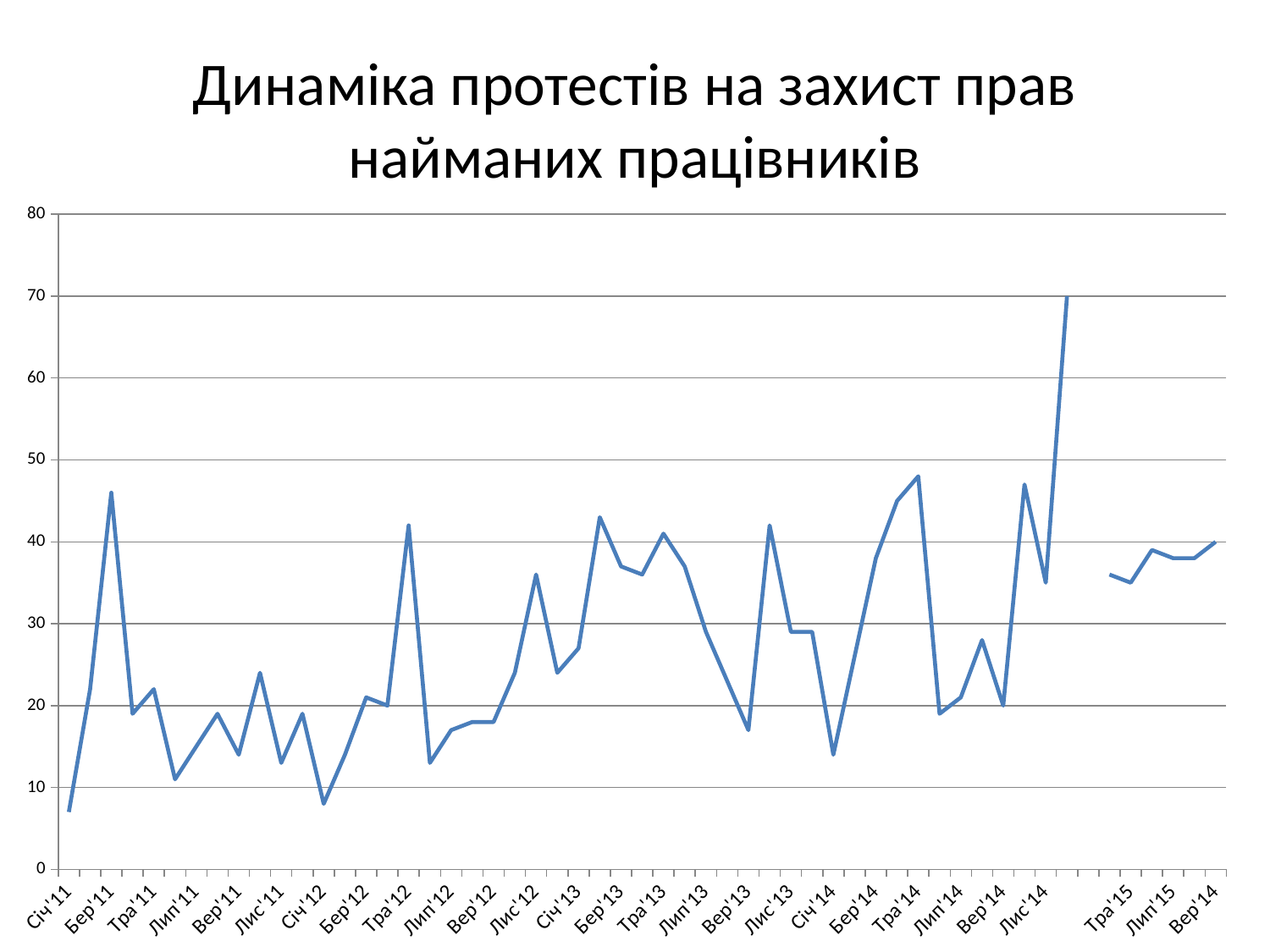
Which is larger, the value for Бер'11 or the value for Тра'11? Бер'11 Is the value for Бер'11 greater or less than 40? greater Is the value for Вер'13 greater or less than 20? less Is the value for Тра'14 greater or less than 40? greater Does the line rise or fall between Січ'11 and Бер'11? rise What is the title of the chart? Динаміка протестів на захист прав найманих працівників What is the highest value shown on the vertical axis? 80 What kind of chart is shown on the slide? line chart